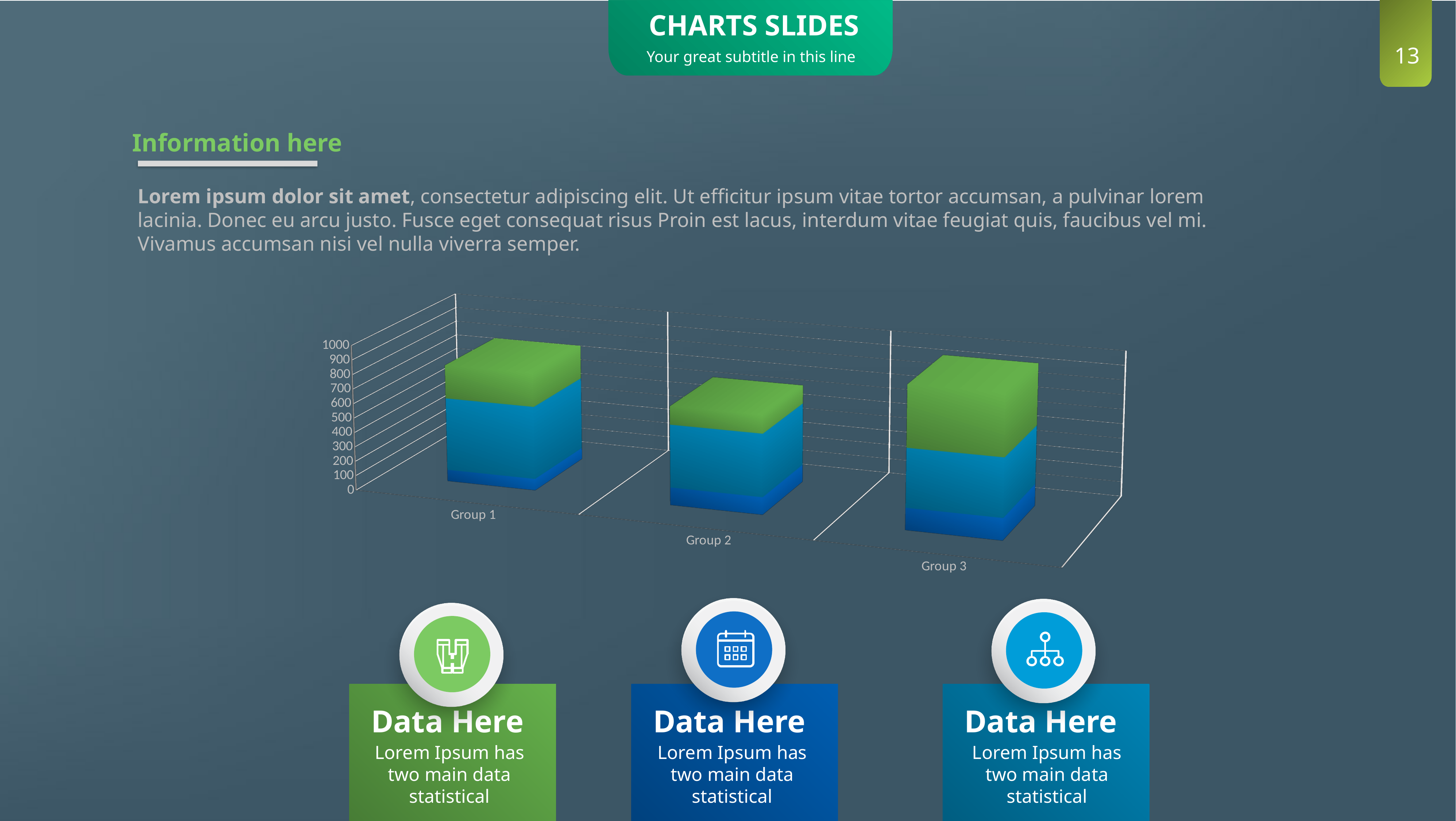
How many stacked segments make up each bar in the chart? 3 Is the total for Group 2 greater or less than 1000? less How many groups (categories) are shown on the x axis of the chart? 3 What is the highest value shown on the vertical axis of the chart? 1000 Which of Group 1 and Group 2 has the taller stacked bar? Group 1 What kind of chart is shown on the slide? Stacked bar chart Which group has the shortest stacked bar in the chart? Group 2 What are the category labels along the x axis of the chart? Group 1, Group 2, Group 3